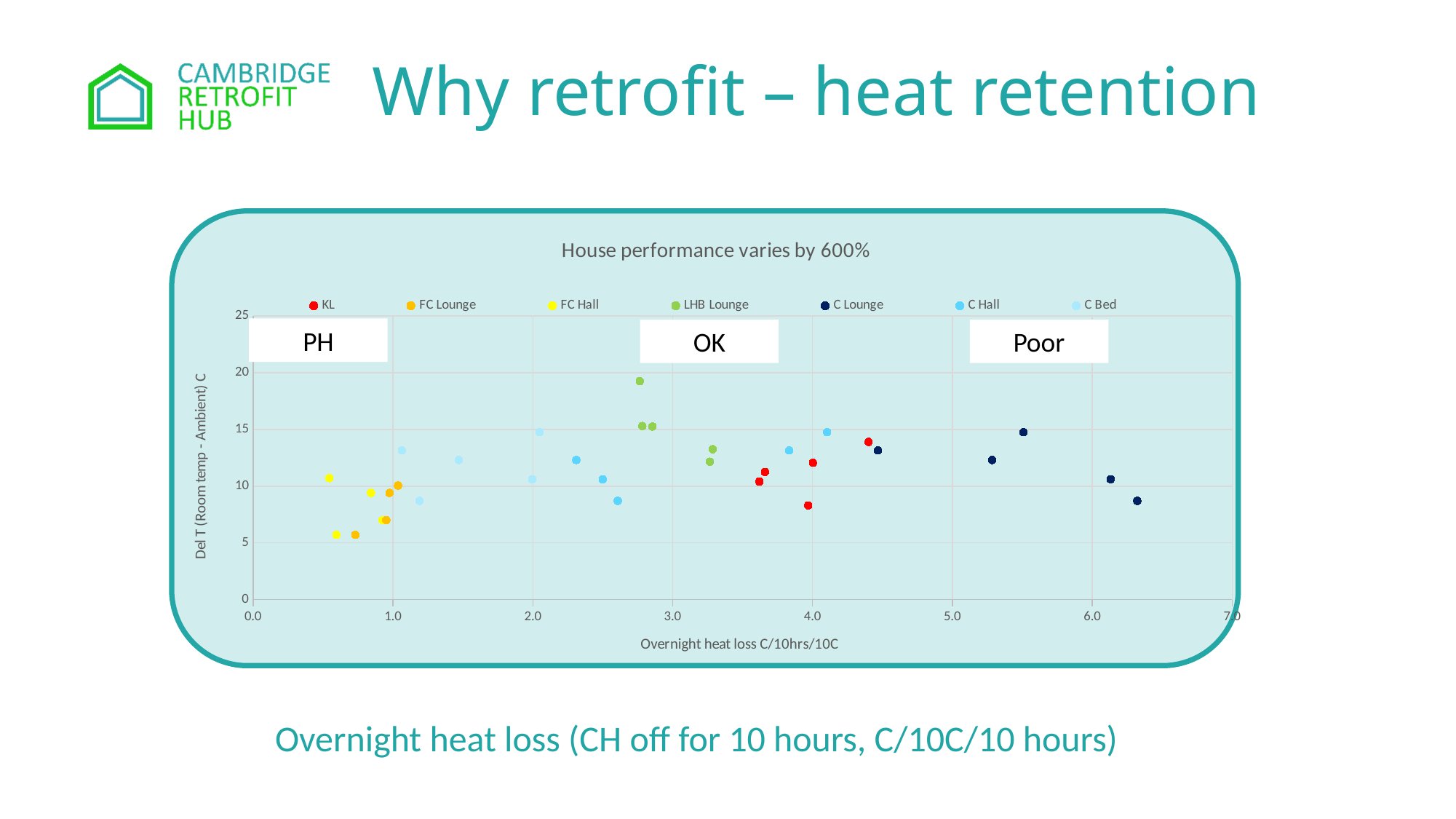
Which series has the point with the highest Del T value on the chart? LHB Lounge Which series has points with larger overnight heat loss values, KL or FC Lounge? KL Which series has the point with the lowest overnight heat loss value on the chart? FC Hall Is the overnight heat loss for the FC Hall points greater or less than 2.0? less What kind of chart is shown on the slide? Scatter chart Is the overnight heat loss for the C Lounge points greater or less than 4.0? greater How many series does the chart's legend list? 7 What is the label on the chart's x axis? Overnight heat loss C/10hrs/10C Is the highest Del T value for LHB Lounge greater or less than 15? greater Which series has the points with the largest overnight heat loss values on the chart? C Lounge What is the title of the chart? House performance varies by 600%